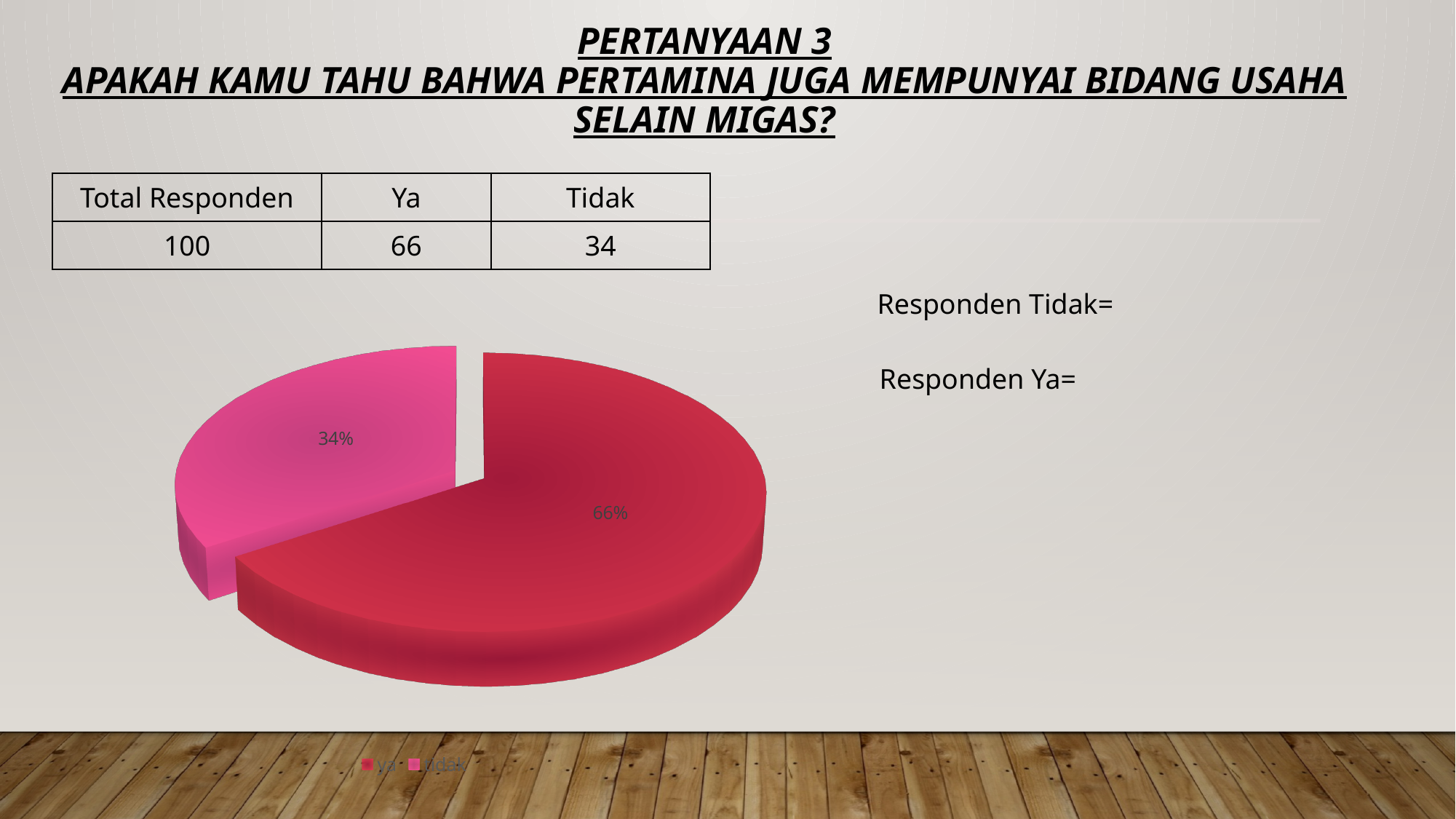
Which slice of the pie chart is the largest? ya Which slice of the pie chart is the smallest? tidak What is the difference in percentage points between the 'ya' slice and the 'tidak' slice? 32 What percentage of the pie chart is labelled for the 'tidak' slice? 34% What percentage of the pie chart is labelled for the 'ya' slice? 66% What share of the pie does the 'tidak' slice represent? 34% Which slice of the pie chart is pulled out (exploded) from the rest? tidak How many slices does the pie chart have? 2 What kind of chart is shown on the slide? pie chart How many entries does the legend of the pie chart list? 2 Which is larger in the pie chart, the 'ya' slice or the 'tidak' slice? ya What colour is the 'ya' slice in the pie chart? red